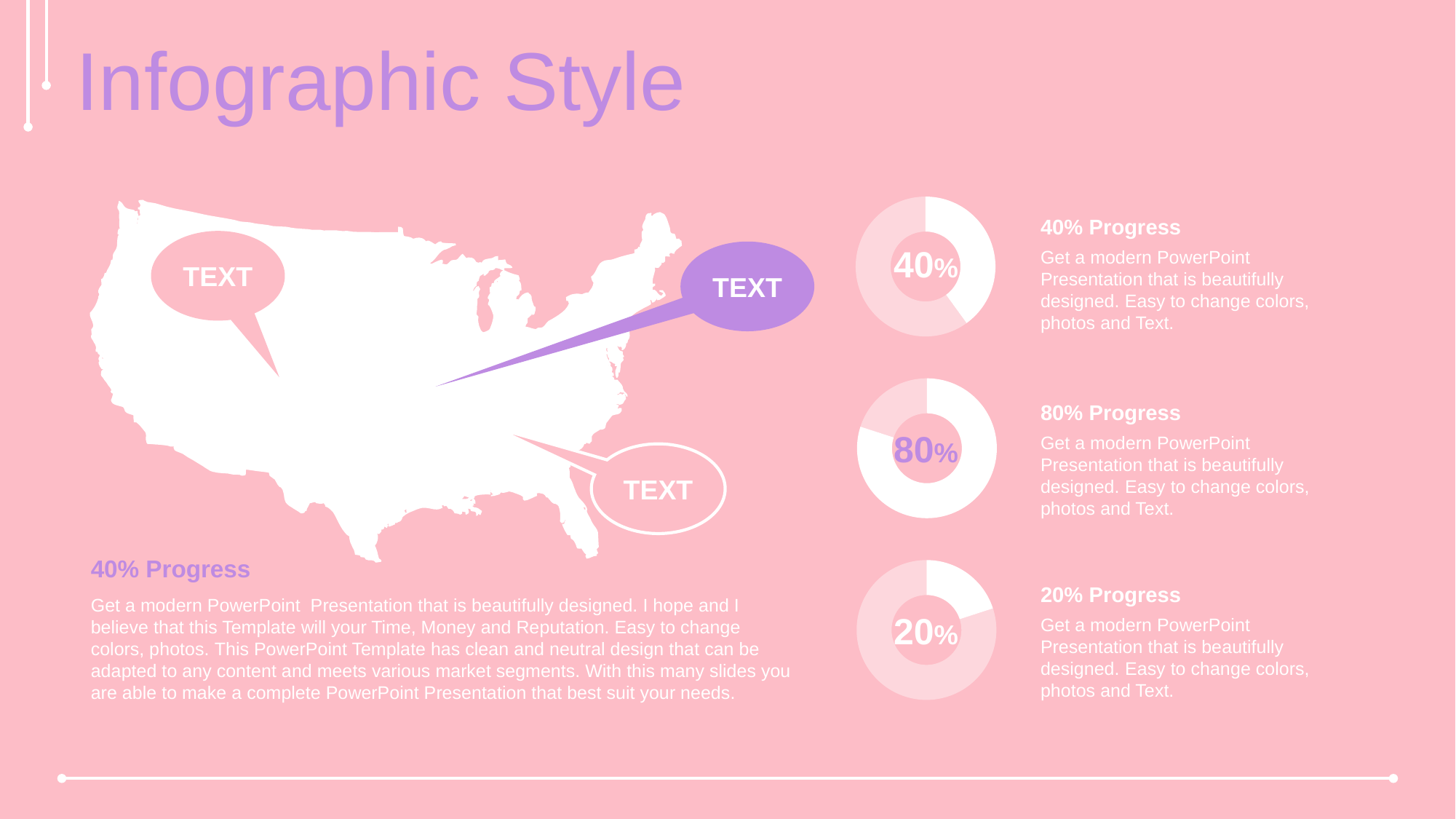
What is the difference between the value in the top donut chart and the value in the bottom donut chart? 20% Which of the three donut charts on the right shows the lowest percentage? The bottom one (20%) Which is larger, the value in the top donut chart or the value in the bottom donut chart? The top donut chart (40%) What kind of chart is used to show the progress percentages on the right side of the slide? Donut chart What heading appears next to the middle donut chart? 80% Progress Which of the three donut charts on the right shows the highest percentage? The middle one (80%) How many donut charts are on the slide? 3 What value is shown in the top donut chart on the right side of the slide? 40% What value is shown in the middle donut chart on the right side of the slide? 80% What is the difference between the value in the middle donut chart and the value in the top donut chart? 40% What value is shown in the bottom donut chart on the right side of the slide? 20% Is the value shown in the bottom donut chart greater or less than 50%? less